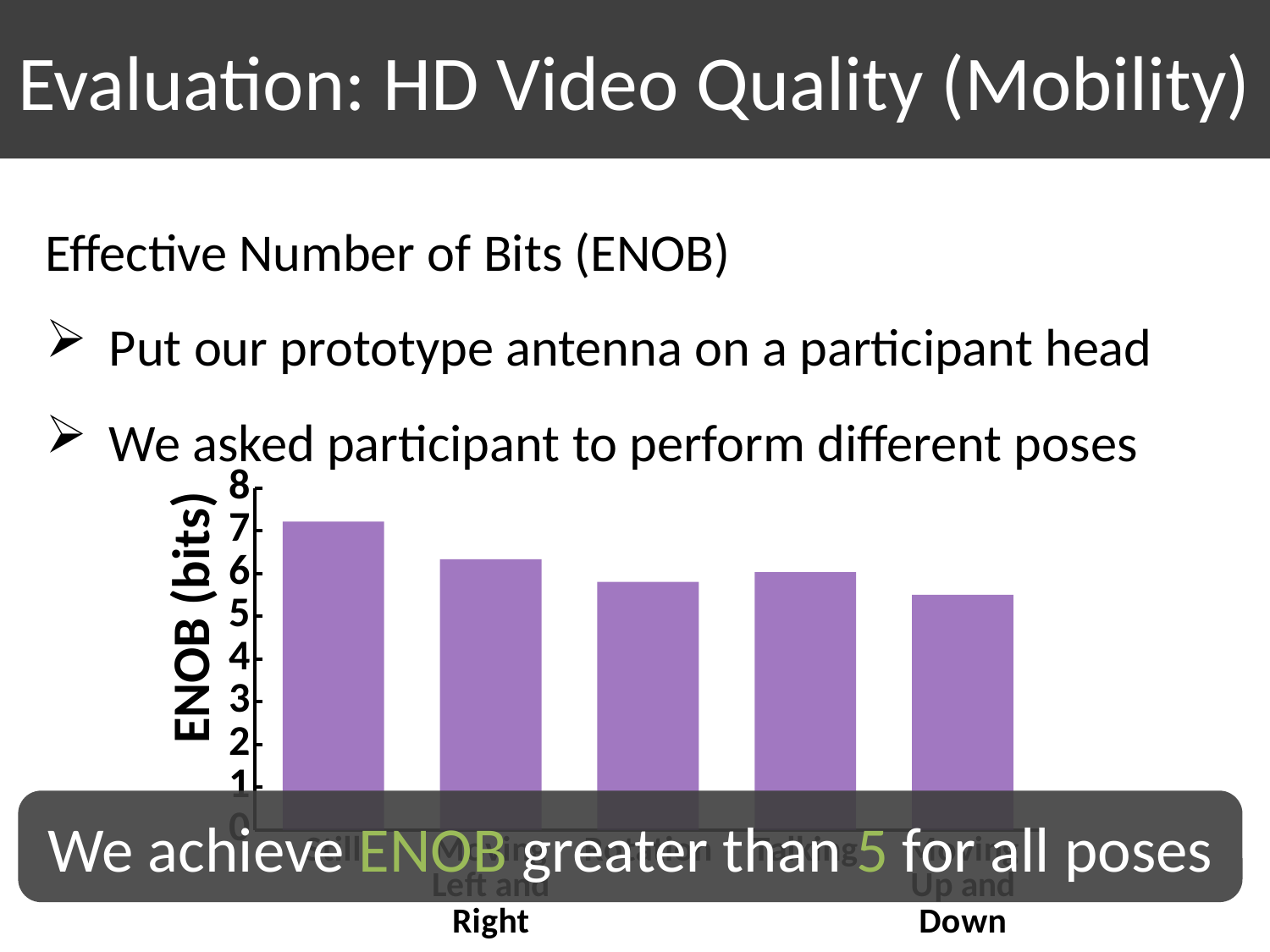
Which bar has the lowest ENOB value? the rightmost bar (Up and Down) Is the value of the rightmost bar (Up and Down) greater or less than 5? greater Which is larger, the second bar from the left (Left and Right) or the third bar from the left? the second bar from the left (Left and Right) What is the label of the y axis of the chart? ENOB (bits) Is the value of the second bar from the left (Left and Right) greater or less than 6? greater Which is larger, the leftmost bar or the rightmost bar? the leftmost bar Is the value of the rightmost bar (Up and Down) greater or less than 6? less What colour are the bars in the chart? purple What kind of chart is shown on the slide? bar chart Which bar has the highest ENOB value? the leftmost bar How many bars are plotted in the chart? 5